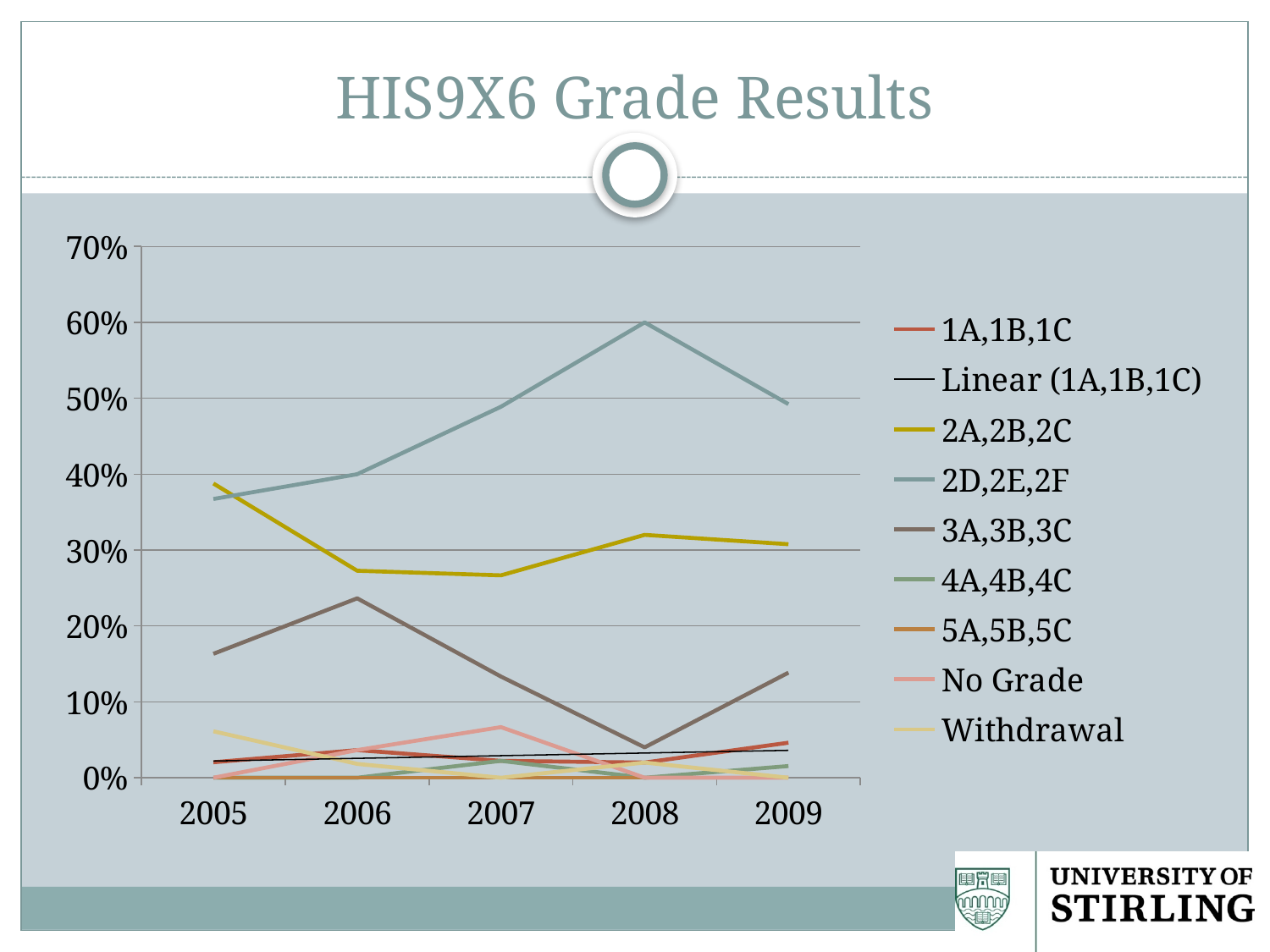
What is the title of the chart on the slide? HIS9X6 Grade Results Which series has the highest value in 2008? 2D,2E,2F Is the value for 2D,2E,2F in 2007 greater or less than 40%? greater Does the 2D,2E,2F series rise or fall from 2005 to 2008? rise How many entries does the chart's legend list? 9 What is the value for 2D,2E,2F in 2008? 60% Is the value for 3A,3B,3C in 2006 greater or less than 20%? greater What kind of chart is shown on the slide? line chart In 2005, which is larger: the value for 2A,2B,2C or the value for 3A,3B,3C? 2A,2B,2C How many years are shown on the x axis of the chart? 5 Is the value for 2A,2B,2C in 2006 greater or less than 30%? less In which year is the 3A,3B,3C series at its lowest? 2008